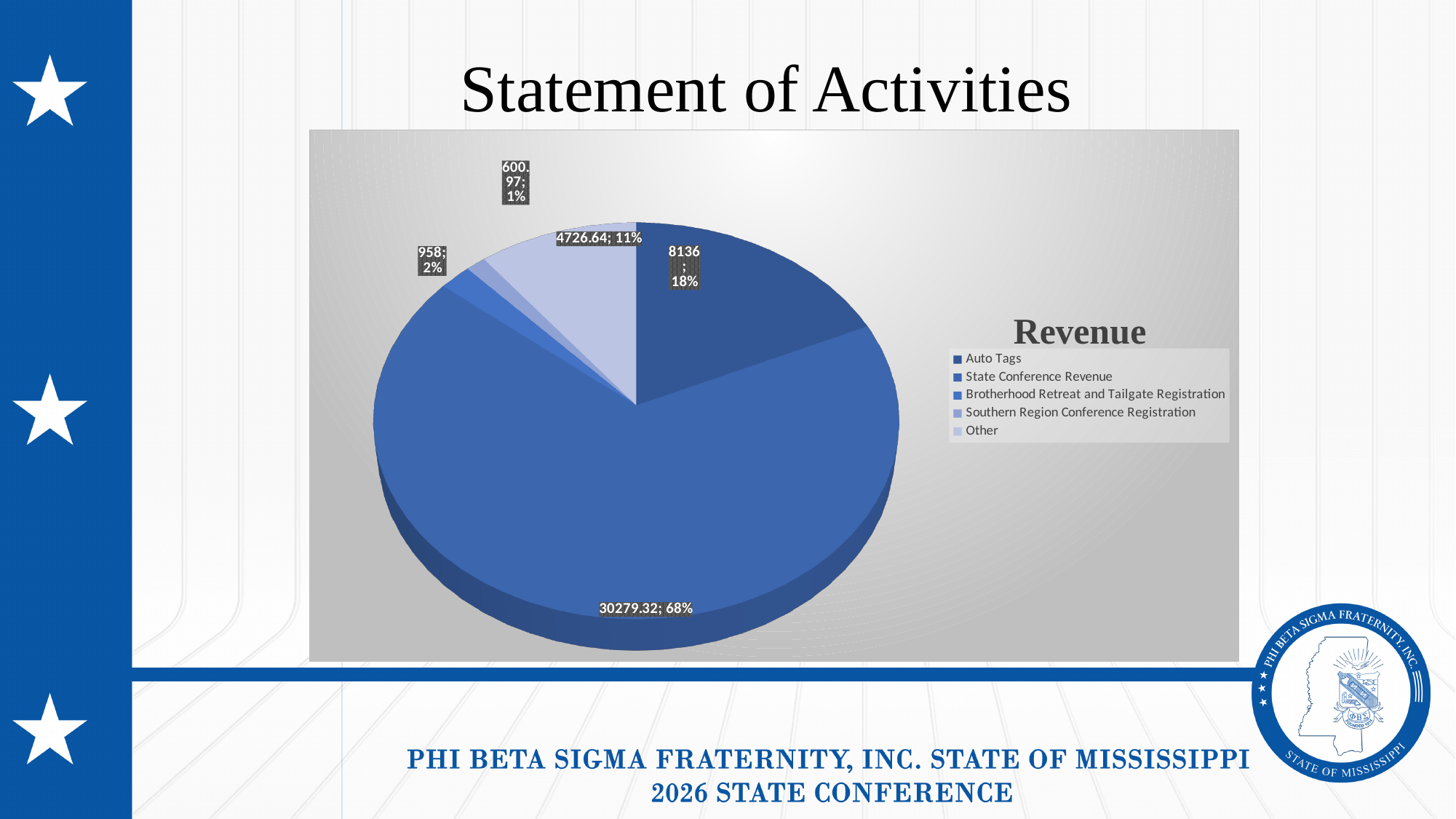
What share of the pie does State Conference Revenue represent? 68% What share of the pie does Southern Region Conference Registration represent? 1% What is the value for Other in the Revenue pie chart? 4726.64 How many categories does the legend of the Revenue pie chart list? 5 What share of the pie does Auto Tags represent? 18% What kind of chart is shown on the slide? pie chart Which category has the smallest slice in the Revenue pie chart? Southern Region Conference Registration Which category has the largest slice in the Revenue pie chart? State Conference Revenue What is the value for Auto Tags in the Revenue pie chart? 8136 Which is larger in the Revenue pie chart, Auto Tags or Other? Auto Tags What is the title of the chart? Revenue What is the value for State Conference Revenue in the Revenue pie chart? 30279.32